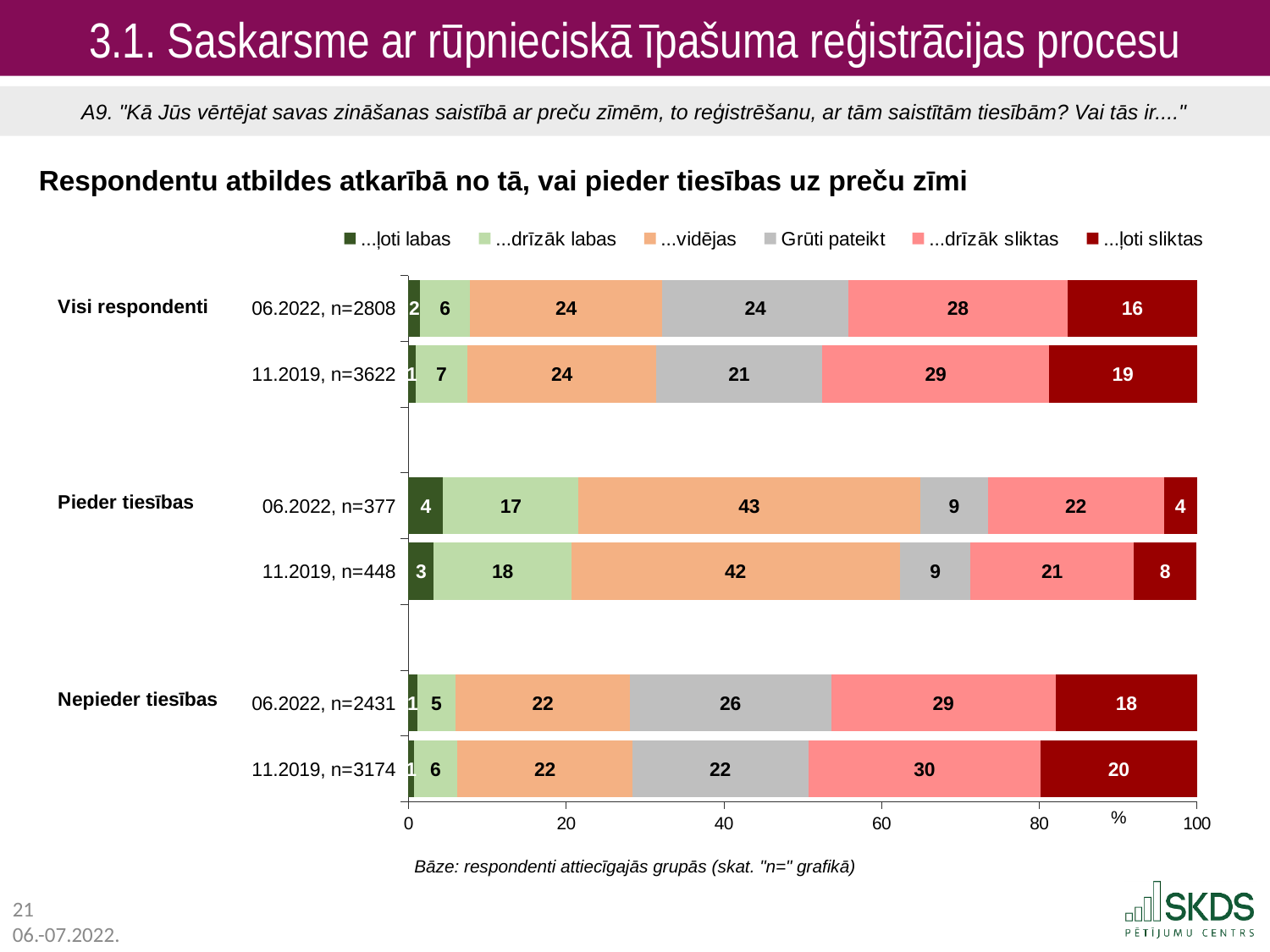
How many series does the legend list? 6 What is the difference between the "...drīzāk sliktas" values for Nepieder tiesības, 11.2019, n=3174 and Pieder tiesības, 11.2019, n=448? 9 Which is larger: the "...ļoti sliktas" value for Nepieder tiesības, 11.2019, n=3174 or for Visi respondenti, 06.2022, n=2808? Nepieder tiesības, 11.2019, n=3174 What is the value of "Grūti pateikt" for Nepieder tiesības, 06.2022, n=2431? 26 How many bars are plotted in the chart? 6 Which legend entry is shown in dark red? ...ļoti sliktas Which bar has the lowest value for "...ļoti sliktas"? Pieder tiesības, 06.2022, n=377 What is the value of "...ļoti sliktas" for Visi respondenti, 11.2019, n=3622? 19 What is the value of "...vidējas" for Pieder tiesības, 06.2022, n=377? 43 What kind of chart is shown on the slide? Stacked bar chart Which bar has the highest value for "...vidējas"? Pieder tiesības, 06.2022, n=377 What is the value of "...drīzāk labas" for Pieder tiesības, 11.2019, n=448? 18